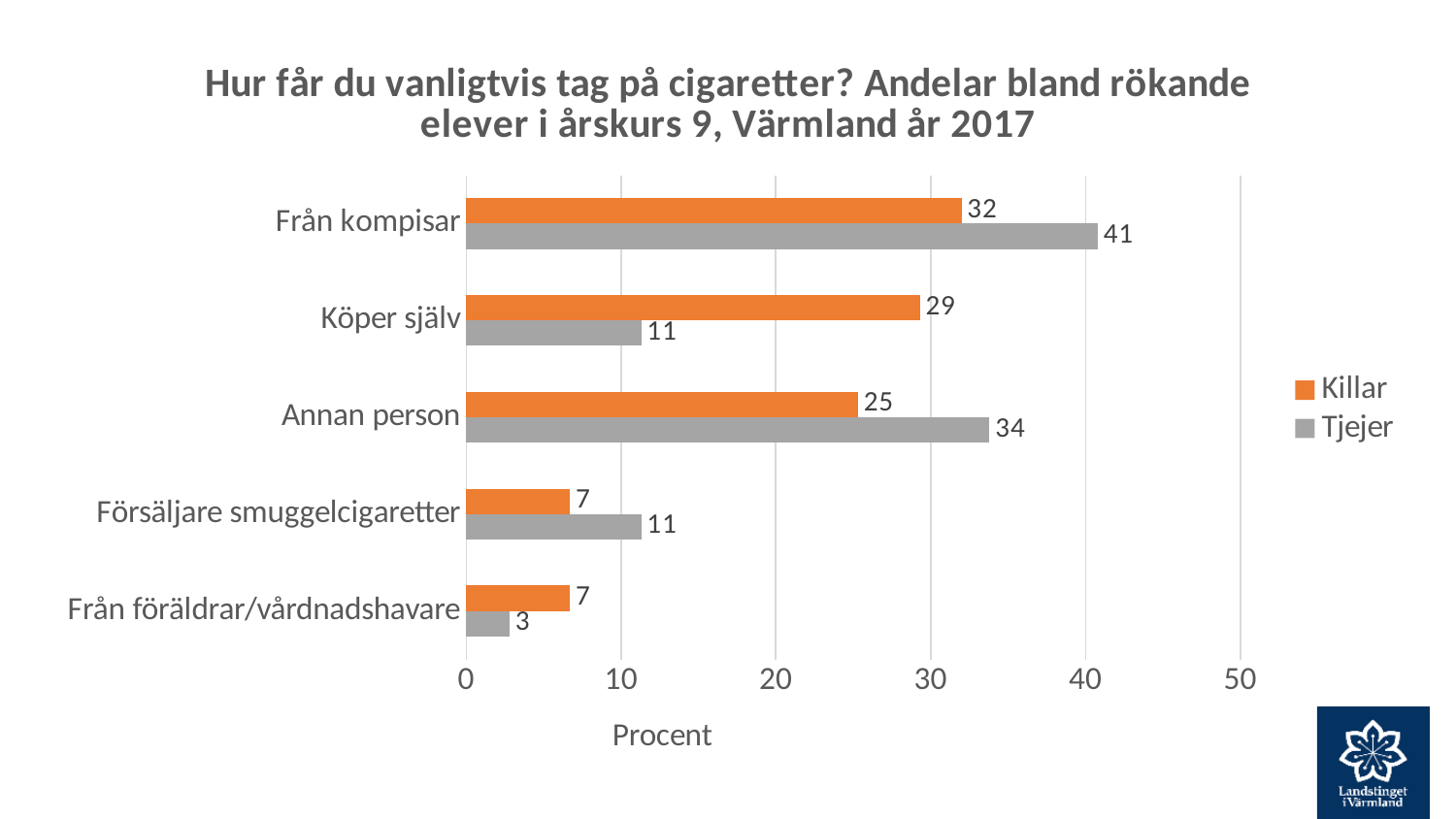
What is the value for Killar in the 'Köper själv' category? 29 For 'Annan person', which series has the larger value, Killar or Tjejer? Tjejer What kind of chart is shown on the slide? Bar chart What is the label of the x axis? Procent What is the difference between the Tjejer and Killar values for 'Köper själv'? 18 What is the value for Tjejer in the 'Annan person' category? 34 Is the value for Tjejer in 'Från kompisar' greater or less than 40? greater Which category has the highest value for Killar? Från kompisar Which category has the lowest value for Tjejer? Från föräldrar/vårdnadshavare What is the value for Tjejer in the 'Från kompisar' category? 41 How many series does the legend list? 2 How many categories are shown on the chart? 5